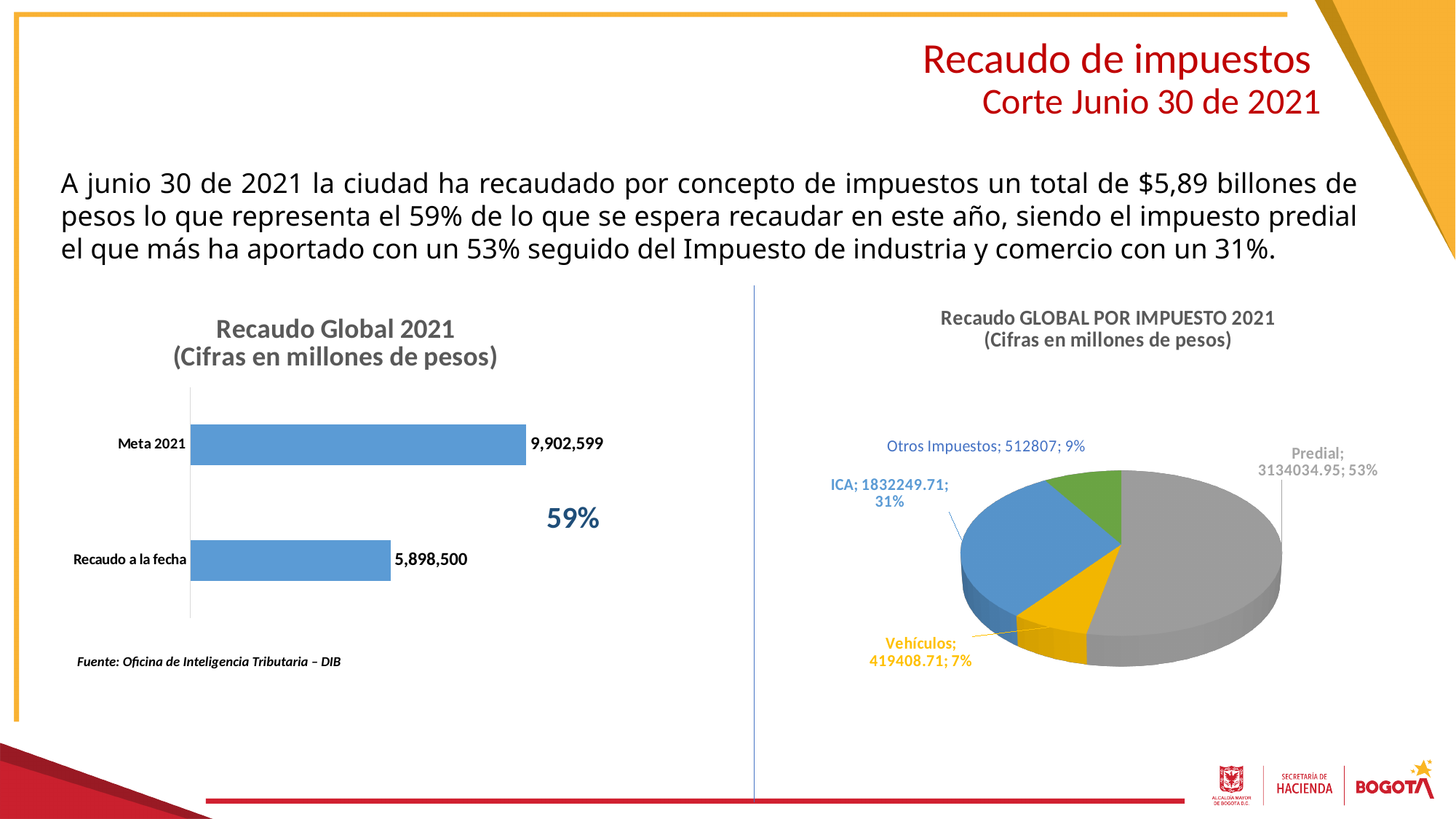
In the 'Recaudo GLOBAL POR IMPUESTO 2021' pie chart, which tax has the smallest slice? Vehículos In the 'Recaudo Global 2021' bar chart, what percentage is shown between the two bars? 59% In the 'Recaudo Global 2021' bar chart, what is the value for Meta 2021? 9,902,599 In the 'Recaudo GLOBAL POR IMPUESTO 2021' pie chart, which tax has the largest slice? Predial In the 'Recaudo Global 2021' bar chart, what is the value for Recaudo a la fecha? 5,898,500 How many slices does the 'Recaudo GLOBAL POR IMPUESTO 2021' pie chart have? 4 In the 'Recaudo Global 2021' bar chart, what is the difference between Meta 2021 and Recaudo a la fecha? 4,004,099 In the 'Recaudo GLOBAL POR IMPUESTO 2021' pie chart, what share does ICA represent? 31% What kind of chart is 'Recaudo Global 2021'? Bar chart In the 'Recaudo GLOBAL POR IMPUESTO 2021' pie chart, what is the value for Predial? 3134034.95 In the 'Recaudo GLOBAL POR IMPUESTO 2021' pie chart, what is the value for Vehículos? 419408.71 In the 'Recaudo Global 2021' bar chart, which category has the larger value, Meta 2021 or Recaudo a la fecha? Meta 2021